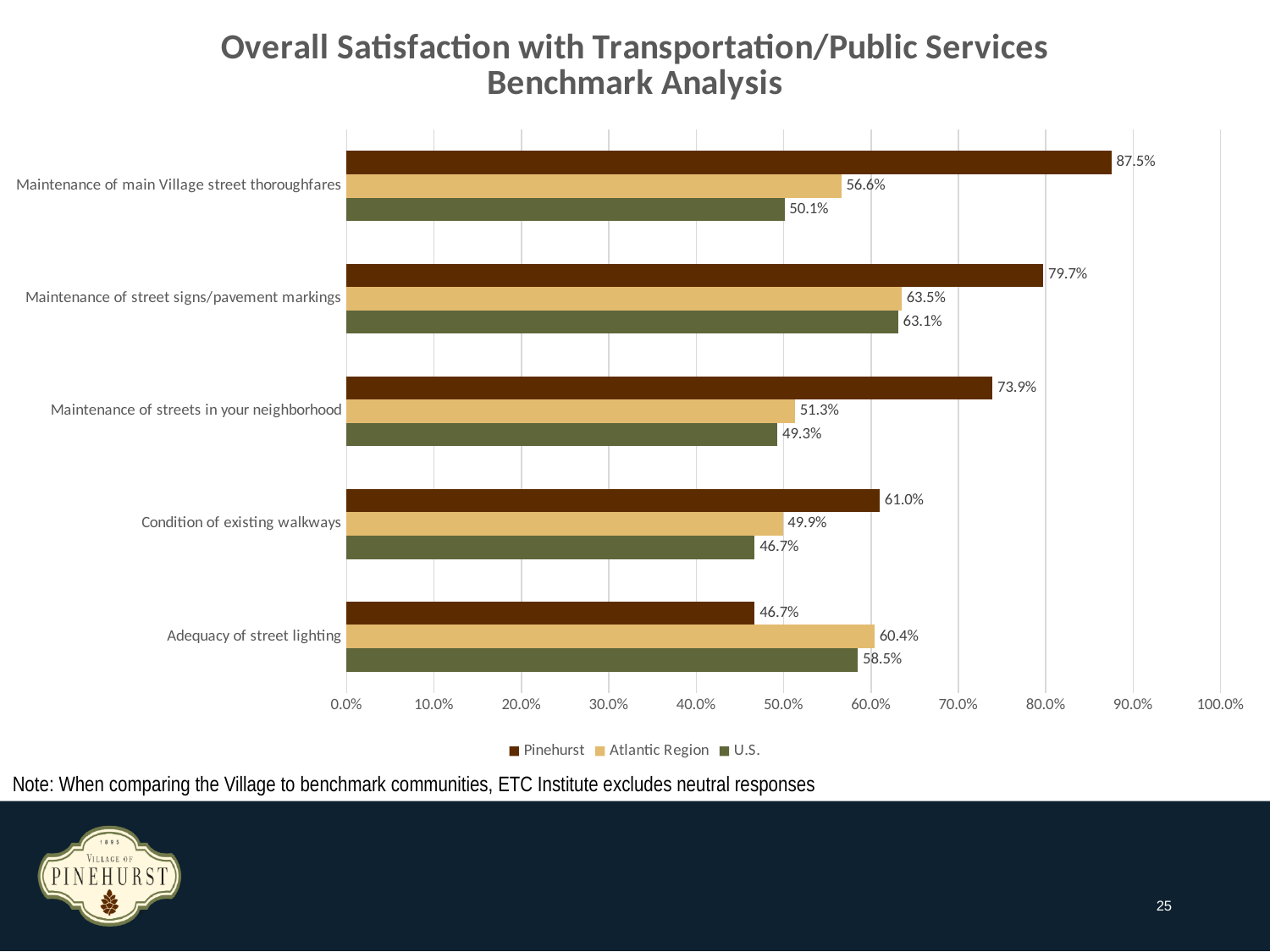
What is the Pinehurst value for Maintenance of main Village street thoroughfares? 87.5% Which series is shown in the dark brown colour? Pinehurst What is the U.S. value for Adequacy of street lighting? 58.5% What is the difference between the Pinehurst and U.S. values for Maintenance of streets in your neighborhood? 24.6% What is the Atlantic Region value for Condition of existing walkways? 49.9% Which category has the highest Pinehurst value? Maintenance of main Village street thoroughfares What kind of chart is shown on the slide? Bar chart For Adequacy of street lighting, which is larger: the Pinehurst value or the Atlantic Region value? Atlantic Region Is the Pinehurst value for Maintenance of street signs/pavement markings greater or less than 70.0%? greater Which category has the lowest Pinehurst value? Adequacy of street lighting How many categories are shown on the chart? 5 How many series does the legend list? 3